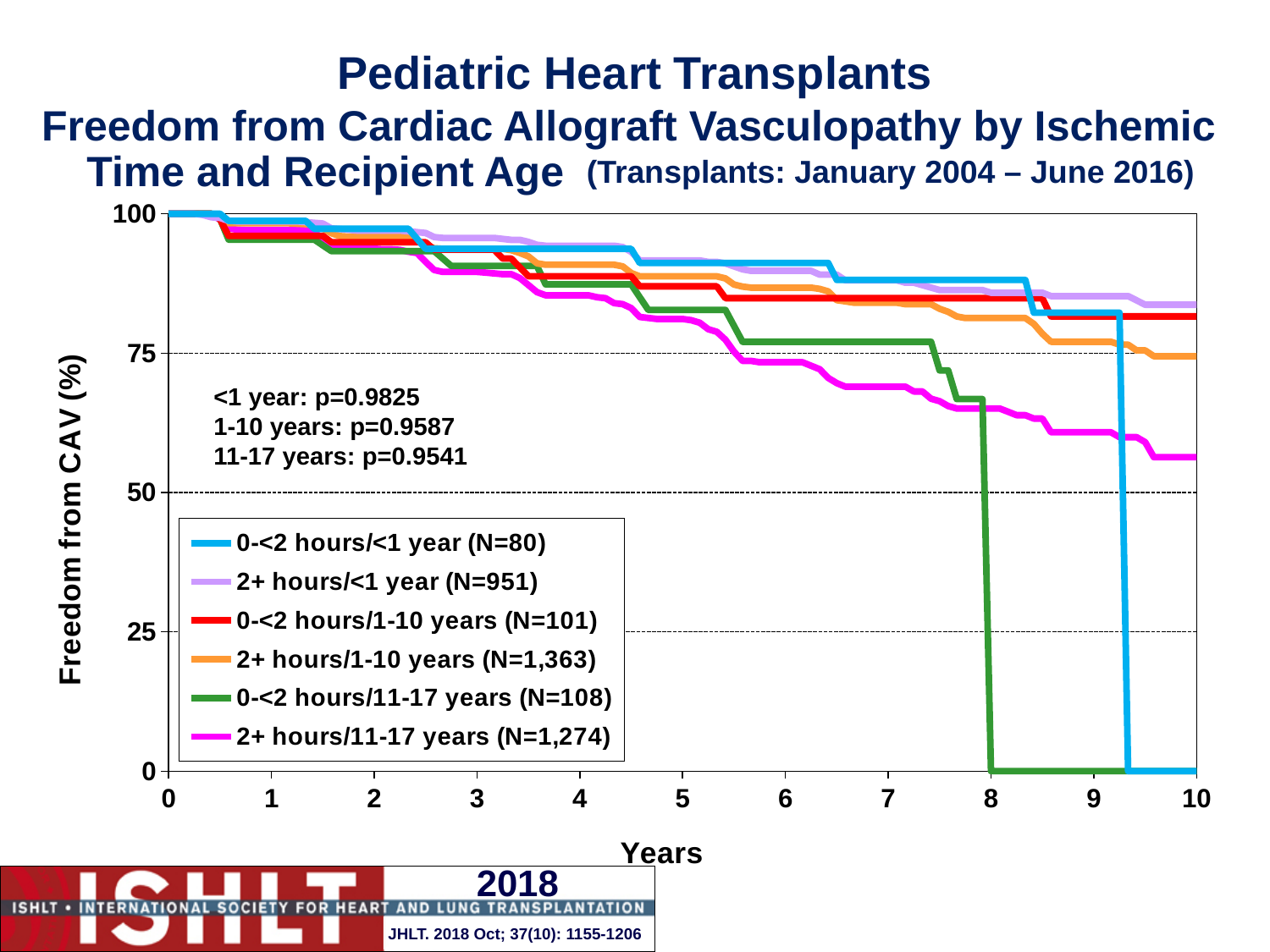
Is the value for 2+ hours/11-17 years at 8 years greater or less than 75? less Among the three 2+ hours groups, which has the lowest freedom from CAV at 10 years? 2+ hours/11-17 years Is the value for 2+ hours/11-17 years at 10 years greater or less than 75? less What kind of chart is shown on the slide? line chart What is the N for the 2+ hours/1-10 years group shown in the legend? N=1,363 Do the freedom from CAV values rise or fall as years increase? fall Is the value for 0-<2 hours/1-10 years at 10 years greater or less than 75? greater How many series does the legend list? 6 At 10 years, which is larger: the value for 2+ hours/<1 year or the value for 2+ hours/11-17 years? 2+ hours/<1 year What p-value is shown for the 11-17 years comparison? p=0.9541